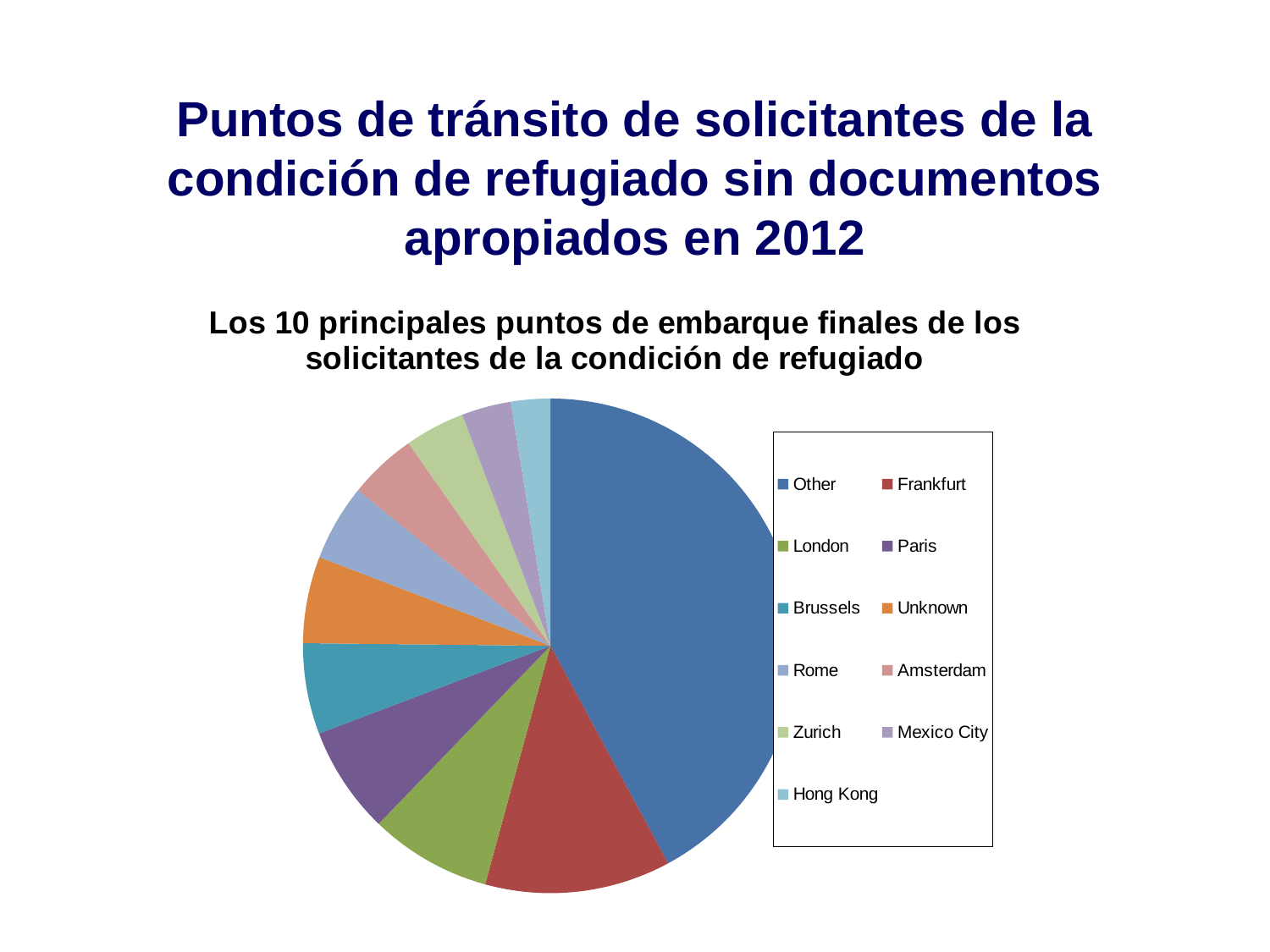
What is the title of the pie chart? Los 10 principales puntos de embarque finales de los solicitantes de la condición de refugiado Which legend entry is shown in orange? Unknown Which slice is larger, Paris or Zurich? Paris Which slice is larger, Unknown or Hong Kong? Unknown Among the named cities (excluding Other and Unknown), which has the largest slice? Frankfurt Which category has the largest slice of the pie chart? Other Which slice is larger, Other or Frankfurt? Other What kind of chart is shown on the slide? pie chart How many slices does the pie chart have? 11